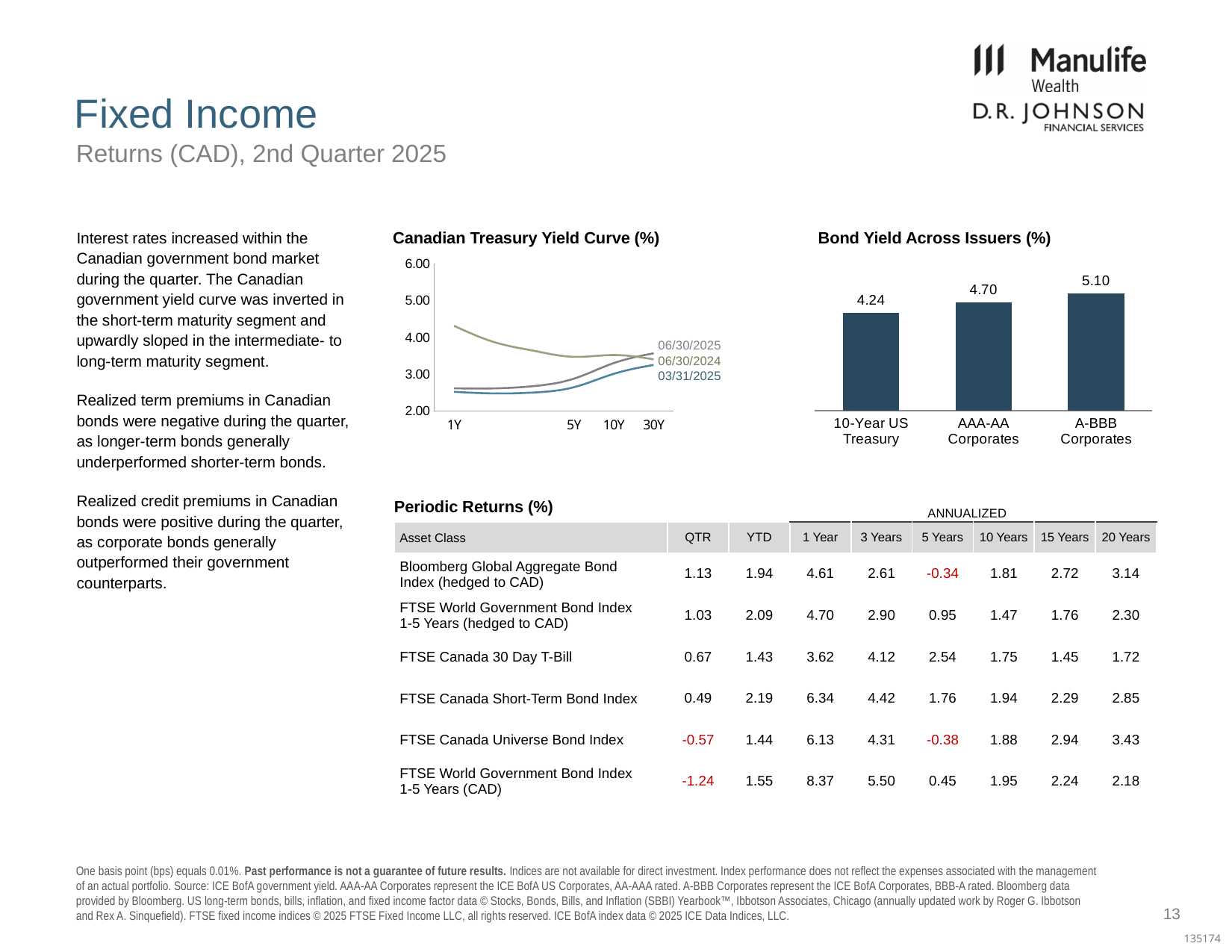
In the Bond Yield Across Issuers (%) chart, what is the value for 10-Year US Treasury? 4.24 What kind of chart is the Bond Yield Across Issuers (%) chart? Bar chart In the Bond Yield Across Issuers (%) chart, what is the value for AAA-AA Corporates? 4.70 What kind of chart is the Canadian Treasury Yield Curve (%) chart? Line chart In the Canadian Treasury Yield Curve (%) chart, does the 06/30/2024 line rise or fall from 1Y to 30Y? fall In the Bond Yield Across Issuers (%) chart, which category has the highest value? A-BBB Corporates In the Canadian Treasury Yield Curve (%) chart, is the 06/30/2024 value at 1Y greater or less than 4.00? greater In the Bond Yield Across Issuers (%) chart, what is the difference between A-BBB Corporates and 10-Year US Treasury? 0.86 In the Bond Yield Across Issuers (%) chart, which is larger, AAA-AA Corporates or 10-Year US Treasury? AAA-AA Corporates In the Bond Yield Across Issuers (%) chart, which category has the lowest value? 10-Year US Treasury How many categories are shown in the Bond Yield Across Issuers (%) chart? 3 How many series does the legend of the Canadian Treasury Yield Curve (%) chart list? 3